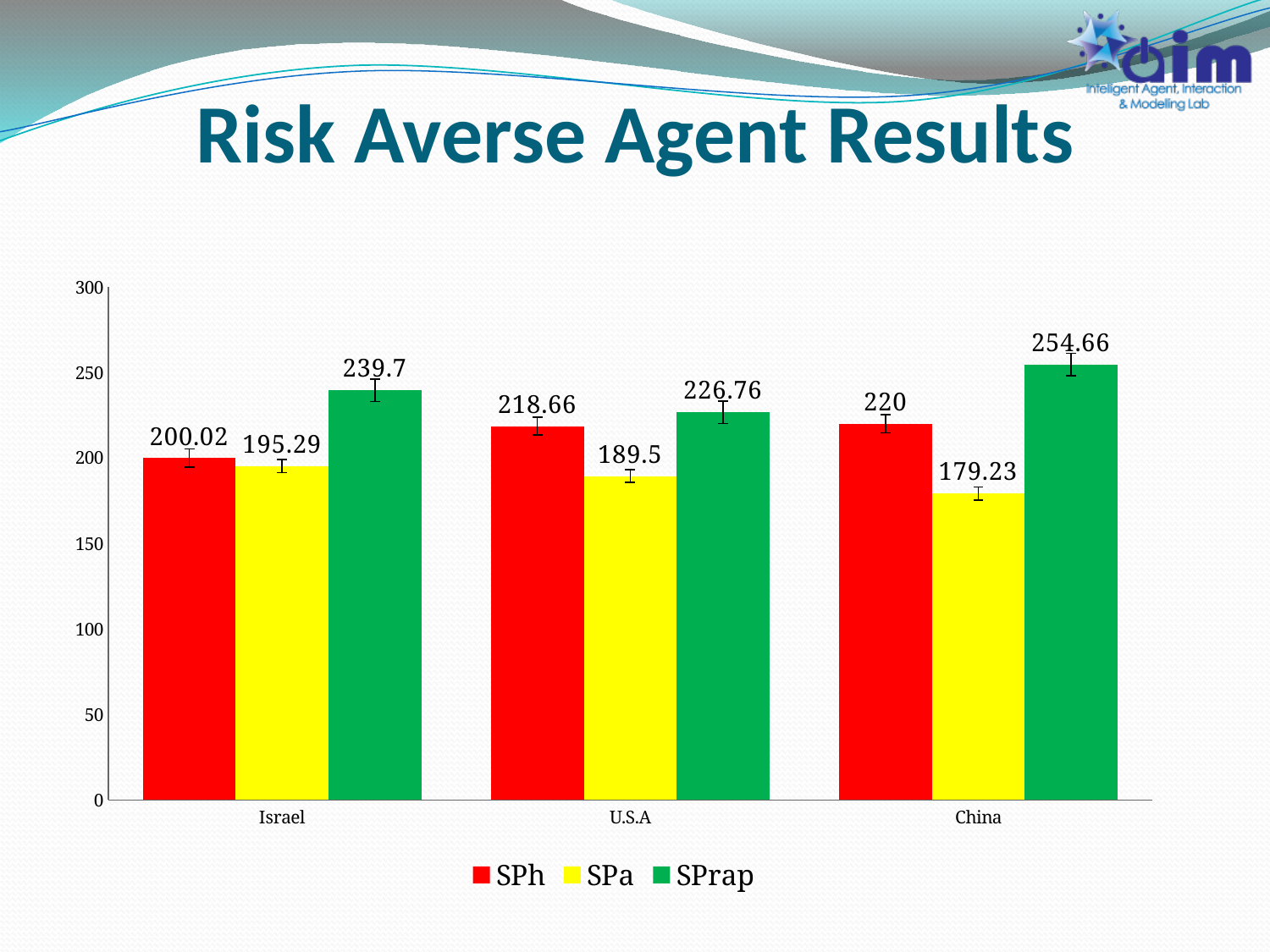
How many series does the legend list? 3 What is the difference between the SPrap and SPh values for Israel? 39.68 What is the SPa value for U.S.A? 189.5 Which country has the highest SPrap value? China Which country has the lowest SPa value? China How many countries are shown on the x axis? 3 What colour represents the SPa series? Yellow Is the SPa value for China greater or less than 200? less Which is larger for U.S.A, the SPh value or the SPa value? SPh What kind of chart is shown on the slide? Bar chart What is the SPh value for Israel? 200.02 What is the SPrap value for China? 254.66